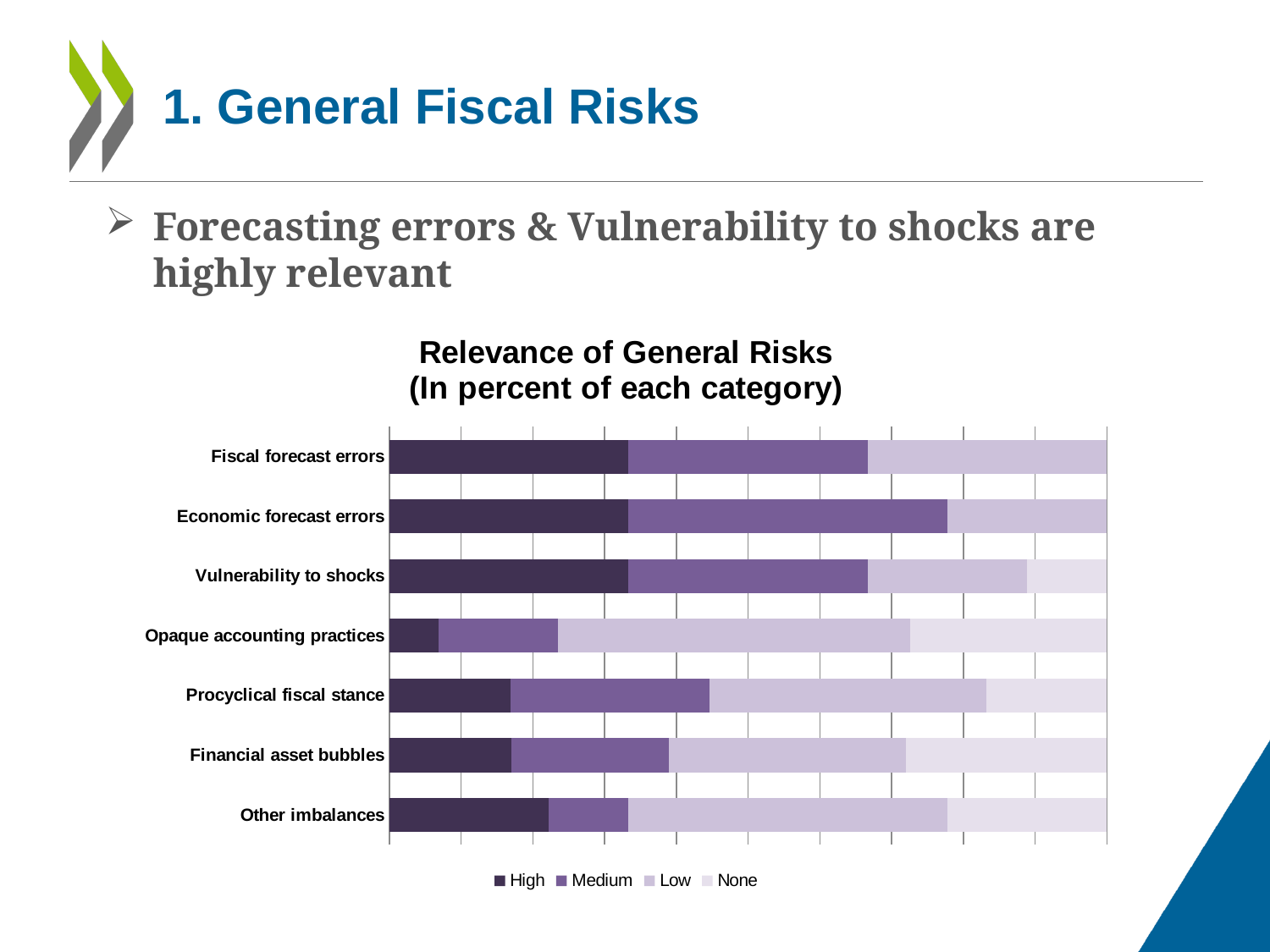
Is the High segment larger for Vulnerability to shocks or for Financial asset bubbles? Vulnerability to shocks Is the High segment larger for Fiscal forecast errors or for Opaque accounting practices? Fiscal forecast errors What kind of chart is shown on the slide? Stacked bar chart How many series does the legend list? 4 Which category has the smallest Medium segment? Other imbalances How many risk categories are plotted on the chart? 7 Is the Low segment larger for Opaque accounting practices or for Fiscal forecast errors? Opaque accounting practices Which category has the largest Medium segment? Economic forecast errors Which category has the smallest High segment? Opaque accounting practices What is the title of the chart? Relevance of General Risks (In percent of each category) What are the four series named in the legend? High, Medium, Low, None